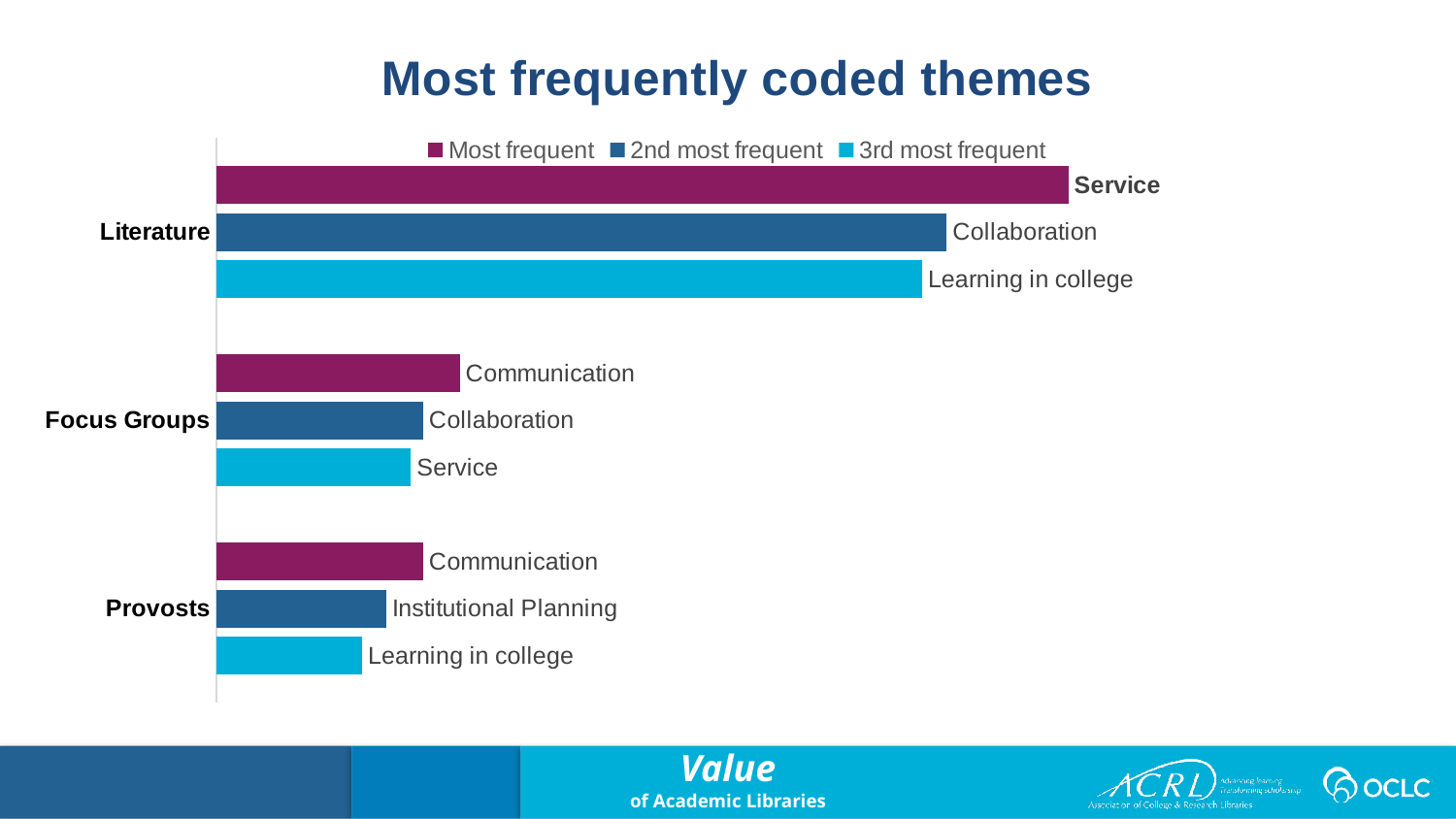
Which theme is labelled as the most frequent for Literature? Service Which theme is labelled as the 3rd most frequent for Focus Groups? Service Which group has the longest bar in the chart? Literature What kind of chart is shown on the slide? bar chart Which theme is labelled as the 2nd most frequent for Provosts? Institutional Planning Which theme is labelled as the most frequent for both Focus Groups and Provosts? Communication How many series does the legend list? 3 Which bar is longer: the most frequent bar for Focus Groups or the most frequent bar for Provosts? Focus Groups What are the three series named in the legend? Most frequent, 2nd most frequent, 3rd most frequent What is the title of the chart? Most frequently coded themes Which theme is labelled as the 2nd most frequent for Literature? Collaboration How many groups (categories) are shown on the vertical axis? 3